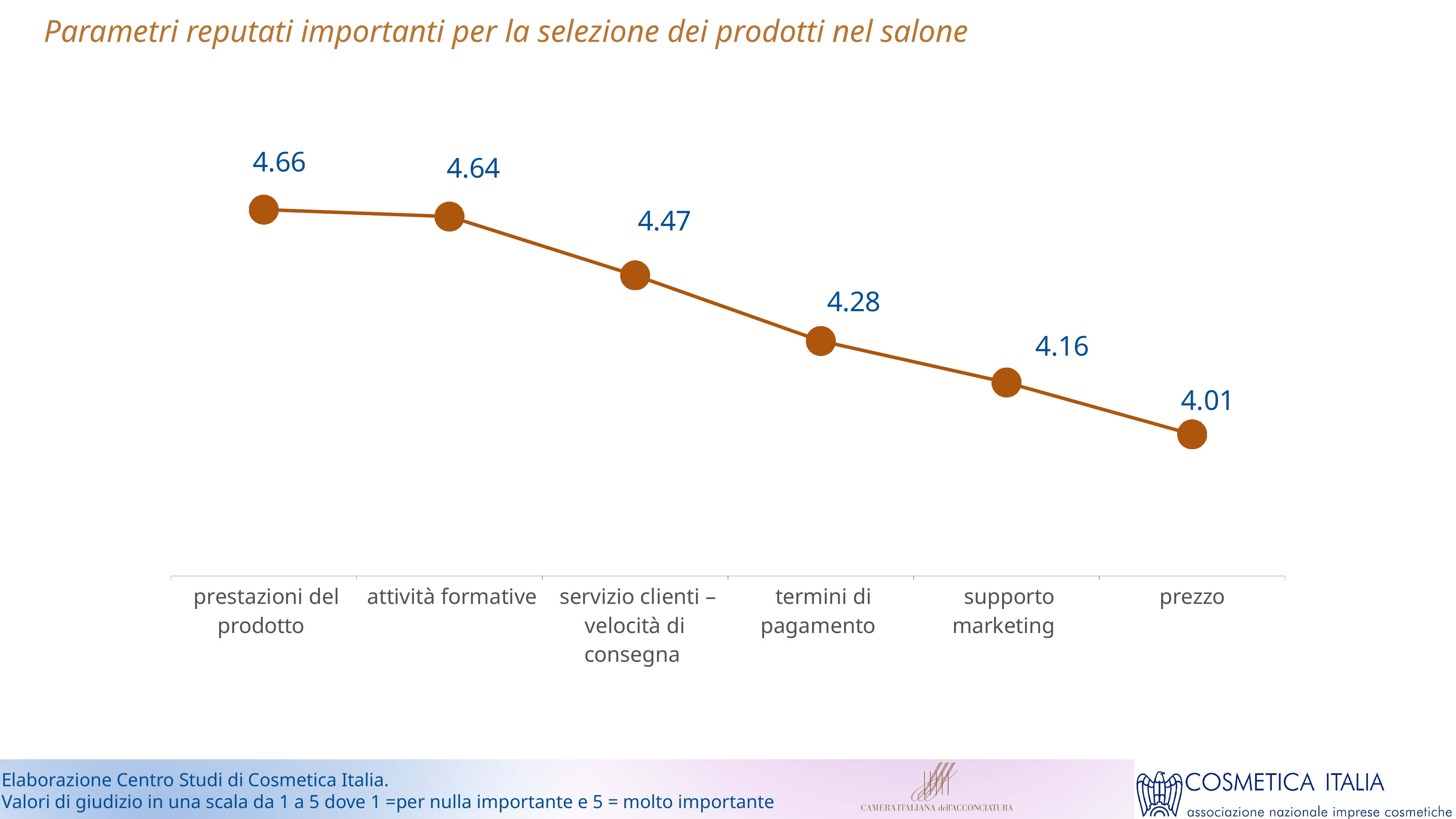
What is the difference between the values for attività formative and servizio clienti – velocità di consegna? 0.17 How many categories are plotted on the chart? 6 Do the values rise or fall from left to right along the x axis? fall What is the value for prezzo? 4.01 What is the difference between the values for prestazioni del prodotto and prezzo? 0.65 Which category has the lowest value? prezzo What is the value for termini di pagamento? 4.28 What kind of chart is shown on the slide? line chart Which category has the highest value? prestazioni del prodotto Which is larger, the value for termini di pagamento or the value for supporto marketing? termini di pagamento What is the value for supporto marketing? 4.16 What is the value for prestazioni del prodotto? 4.66